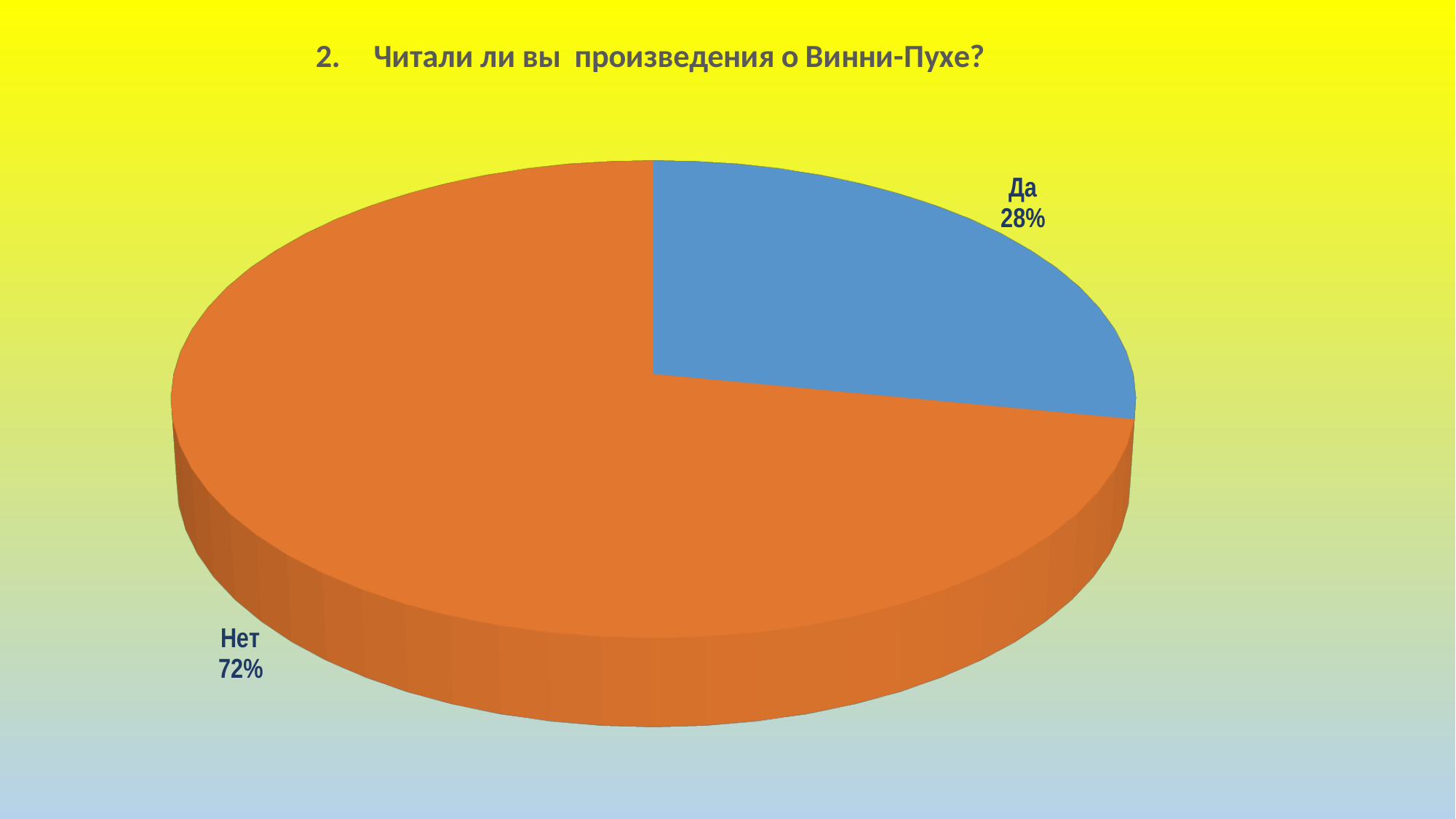
Which slice is the smallest in the pie chart? Да What is the difference in percentage points between the "Нет" and "Да" slices? 44 Which slice is the largest in the pie chart? Нет Which is larger, the "Да" slice or the "Нет" slice? Нет What colour is the "Да" slice? Blue What is the title of the chart? 2. Читали ли вы произведения о Винни-Пухе? What kind of chart is shown on the slide? Pie chart What share of the pie does the "Да" slice represent? 28% How many slices does the pie chart have? 2 What share of the pie does the "Нет" slice represent? 72%